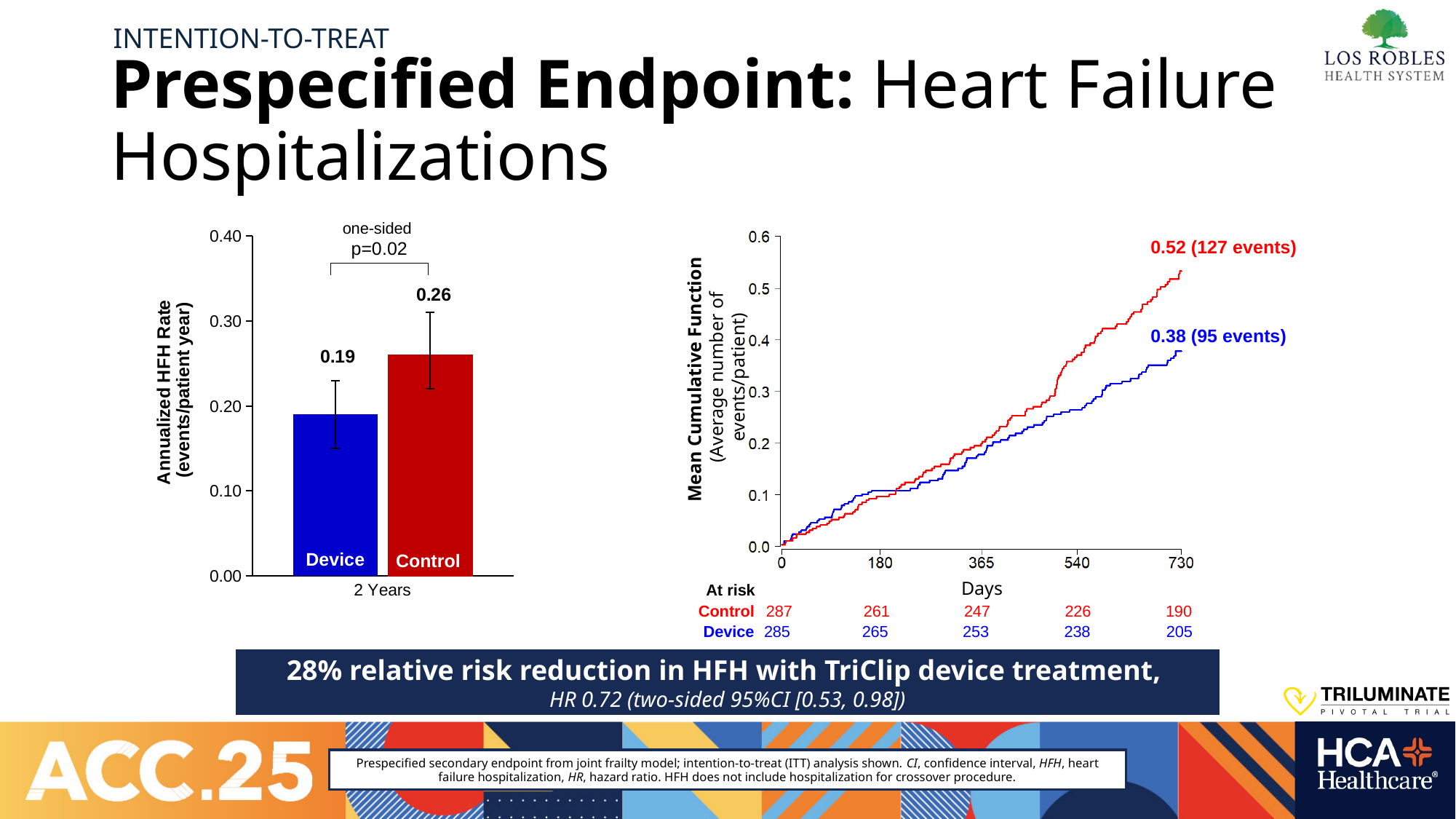
In the line chart on the right, how many series are plotted? 2 In the bar chart on the left, what is the difference between the Control and Device annualized HFH rates? 0.07 In the bar chart on the left, which group has the higher annualized HFH rate? Control In the bar chart on the left, what is the annualized HFH rate for the Control group? 0.26 What kind of chart is shown on the left side of the slide? Bar chart In the line chart on the right, what is the final mean cumulative function value for the Control (red) curve? 0.52 (127 events) In the line chart on the right, what is the final mean cumulative function value for the Device (blue) curve? 0.38 (95 events) In the line chart on the right, do the curves rise or fall as days increase? Rise In the bar chart on the left, how many bars are plotted? 2 In the at-risk table below the line chart, how many Device patients are at risk at 730 days? 205 In the bar chart on the left, what one-sided p-value is shown above the bars? p=0.02 In the bar chart on the left, what is the annualized HFH rate for the Device group? 0.19